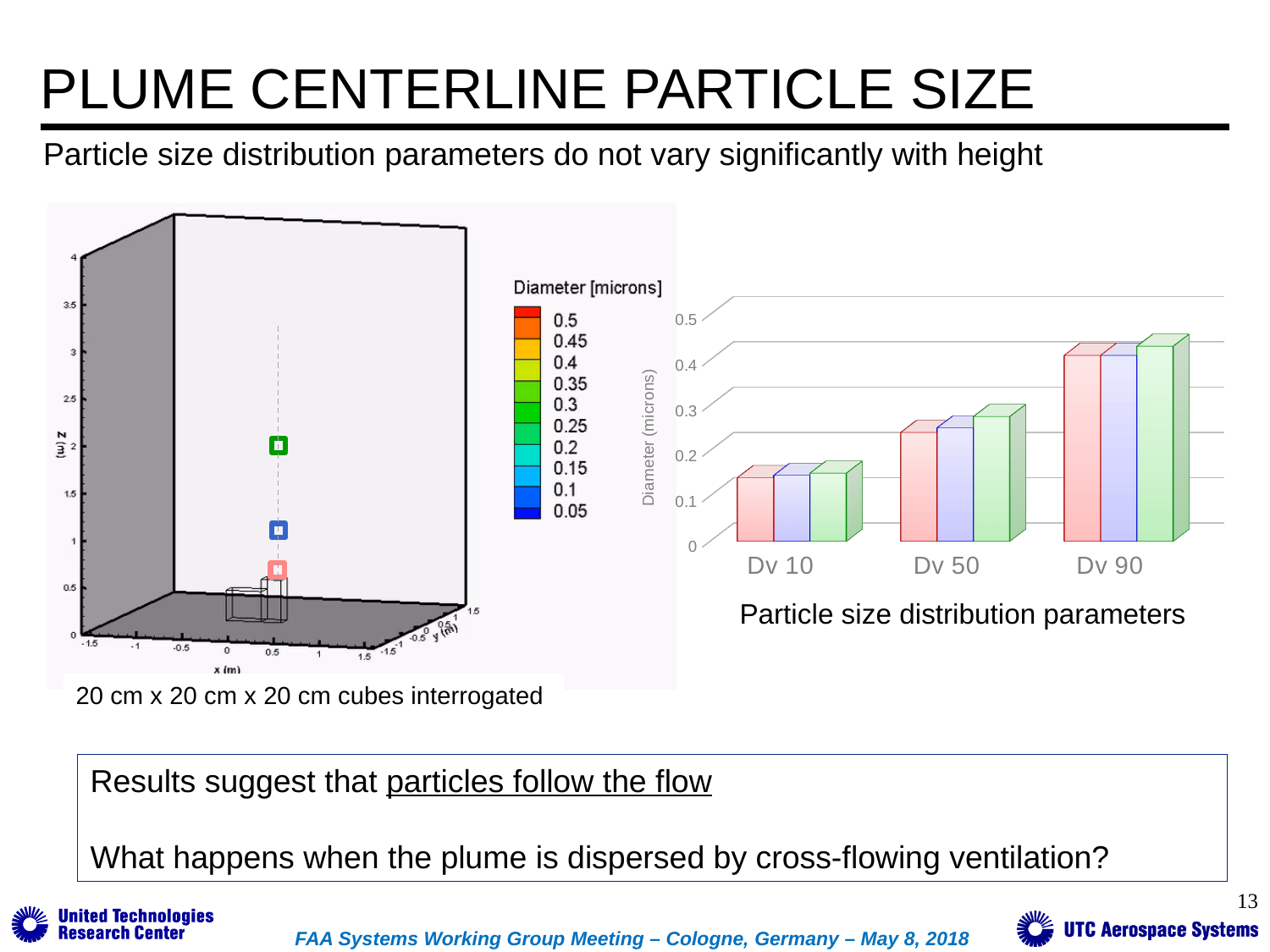
On the bar chart on the right, how many categories are shown on the x axis? 3 On the bar chart on the right, which category has the highest values? Dv 90 On the bar chart on the right, what is the label of the vertical axis? Diameter (microns) On the bar chart on the right, are the bars for Dv 90 greater or less than 0.5? less On the bar chart on the right, do the values rise or fall from Dv 10 to Dv 90? rise On the bar chart on the right, are the bars for Dv 50 greater or less than 0.2? greater On the bar chart on the right, how many bars are plotted for each category? 3 On the bar chart on the right, are the bars for Dv 10 greater or less than 0.2? less On the bar chart on the right, which is larger, the value for Dv 50 or the value for Dv 10? Dv 50 On the bar chart on the right, which category has the lowest values? Dv 10 On the bar chart on the right, what kind of chart is shown? bar chart